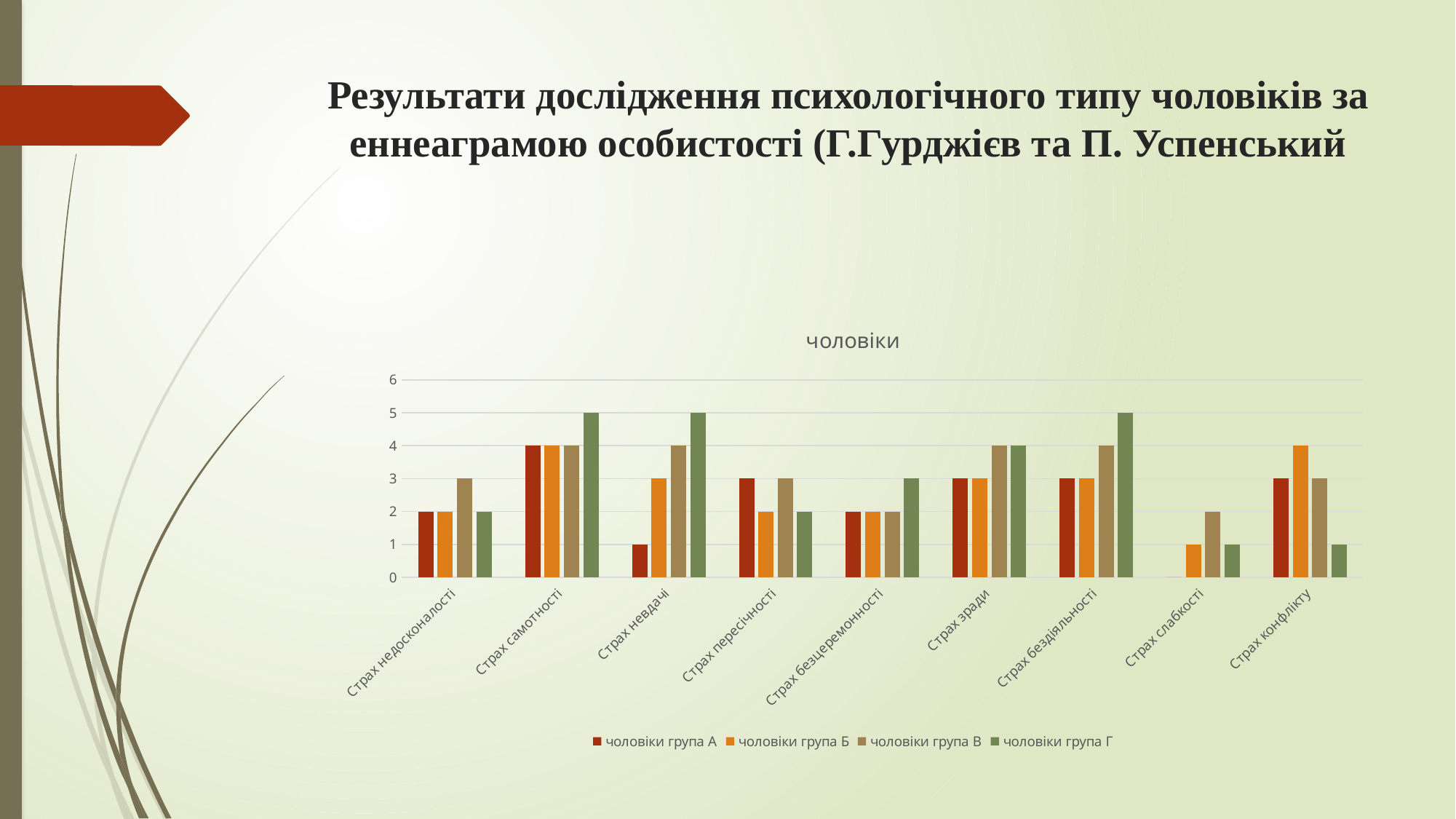
In the category Страх конфлікту, which series has the lowest value? чоловіки група Г How many categories are shown on the x axis? 9 What is the value for чоловіки група Б in the category Страх конфлікту? 4 What kind of chart is shown on the slide? bar chart In the category Страх пересічності, which is larger: the value for чоловіки група А or for чоловіки група Б? чоловіки група А What is the title of the chart? чоловіки What is the value for чоловіки група В in the category Страх недосконалості? 3 What is the difference between the values for чоловіки група Г and чоловіки група А in the category Страх невдачі? 4 How many series does the legend list? 4 In the category Страх невдачі, which series has the highest value? чоловіки група Г What is the value for чоловіки група Г in the category Страх самотності? 5 What is the value for чоловіки група А in the category Страх невдачі? 1